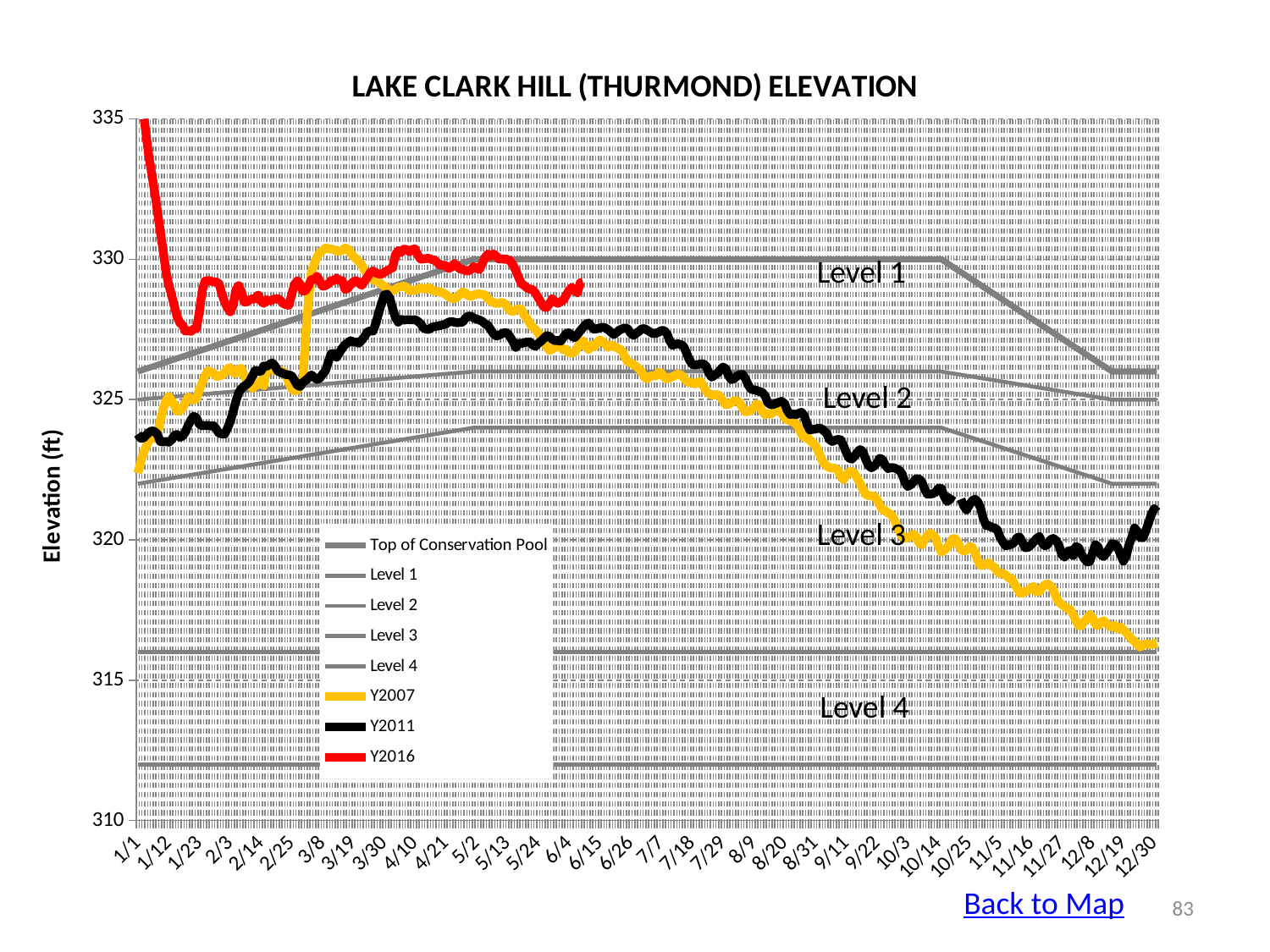
Which of the year series (Y2007, Y2011, Y2016) is highest on 1/1? Y2016 Does the Y2007 line rise or fall from 6/4 to 12/30? Fall On 12/30, which is higher, Y2011 or Y2007? Y2011 Is the Y2007 value on 12/30 greater or less than 320? less Is the Y2011 value on 1/1 greater or less than 325? less How many series does the legend list? 8 Is the Y2011 value on 12/30 greater or less than 325? less What colour is the Y2011 line? Black What is the title of the chart? LAKE CLARK HILL (THURMOND) ELEVATION What kind of chart is shown on the slide? Line chart